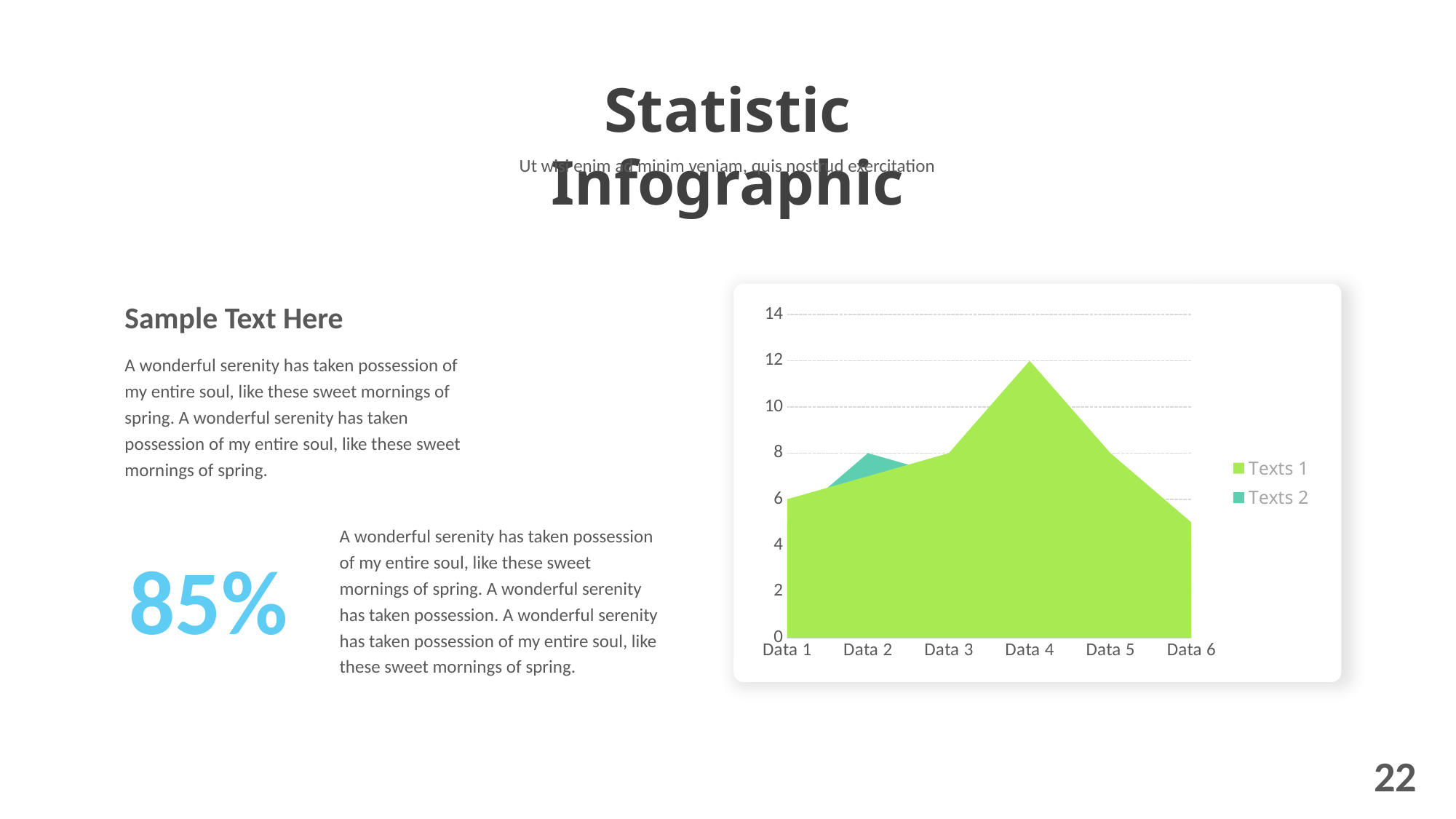
Which category has the lowest value for Texts 1? Data 6 What is the value of Texts 1 at Data 1? 6 Do the Texts 1 values rise or fall from Data 4 to Data 6? Fall Which is larger for Texts 1: the value at Data 4 or the value at Data 1? Data 4 Is the value of Texts 1 at Data 5 greater or less than 6? greater How many series does the chart legend list? 2 What is the value of Texts 1 at Data 4? 12 What are the names of the series listed in the chart legend? Texts 1 and Texts 2 Which category has the highest value for Texts 1? Data 4 How many categories are shown on the x axis of the chart? 6 Is the value of Texts 1 at Data 6 greater or less than 6? less What kind of chart is shown on the slide? Area chart